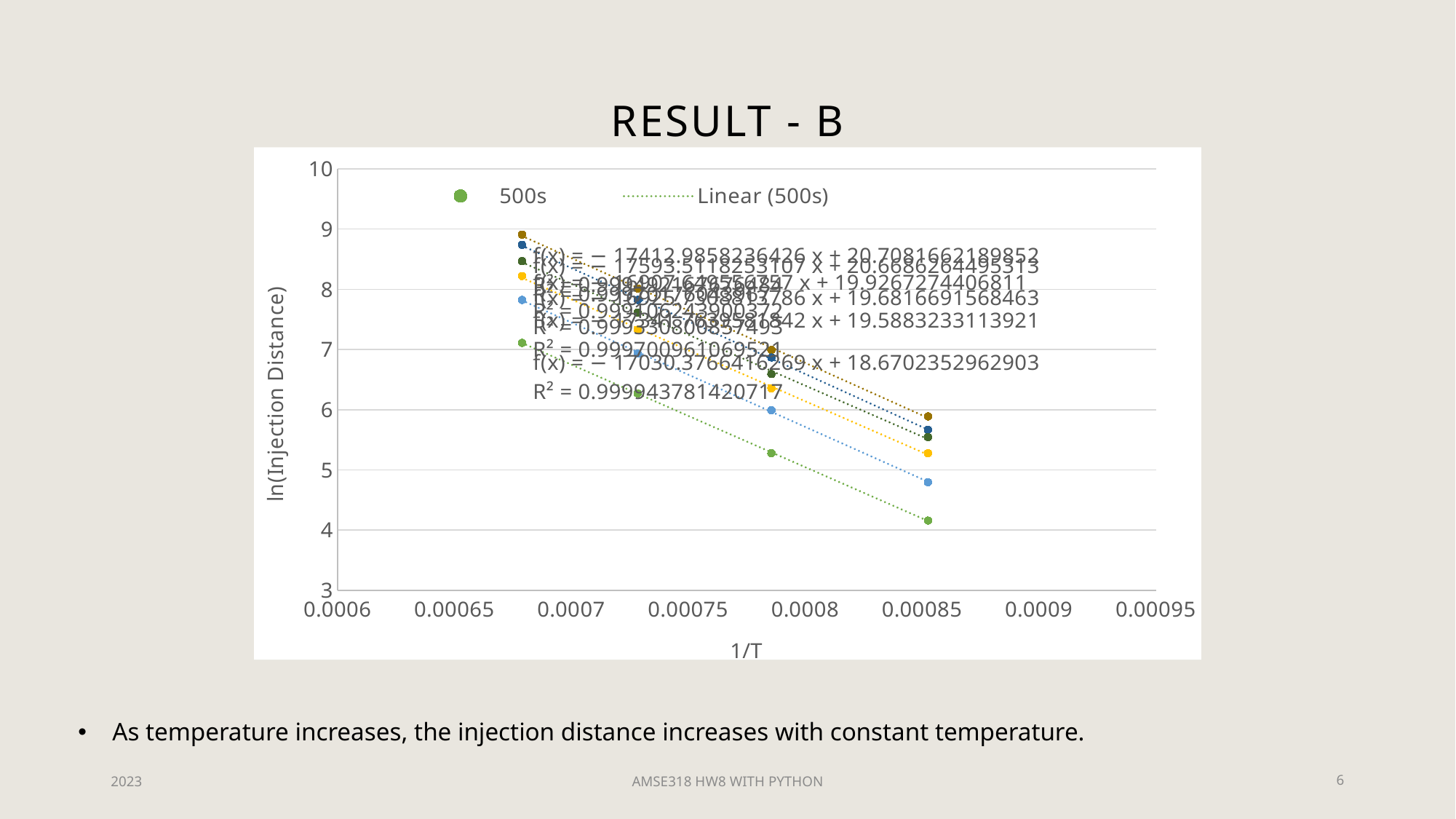
As 1/T increases along the x axis, do the ln(Injection Distance) values rise or fall? Fall What kind of chart is shown on the slide? Scatter chart What is the slope printed in the bottom trendline equation on the chart? − 17030.3766416269 Is the value of the 500s (green) series at its leftmost point (1/T ≈ 0.00068) greater or less than 6? greater Is the value of the 500s (green) series at 1/T = 0.00085 greater or less than 5? less What is the title of the x axis? 1/T How many data points does the 500s (green) series have? 4 What is the R² value printed for the bottom trendline equation (f(x) = − 17030.3766416269 x + 18.6702352962903)? 0.999943781420717 Is the value of the topmost (brown) series at its leftmost point (1/T ≈ 0.00068) greater or less than 8? greater At 1/T = 0.00085, which series has the lowest ln(Injection Distance) value? 500s (green) At 1/T = 0.00085, is the brown series value larger or smaller than the 500s (green) series value? Larger What is the title of the y axis? ln(Injection Distance)